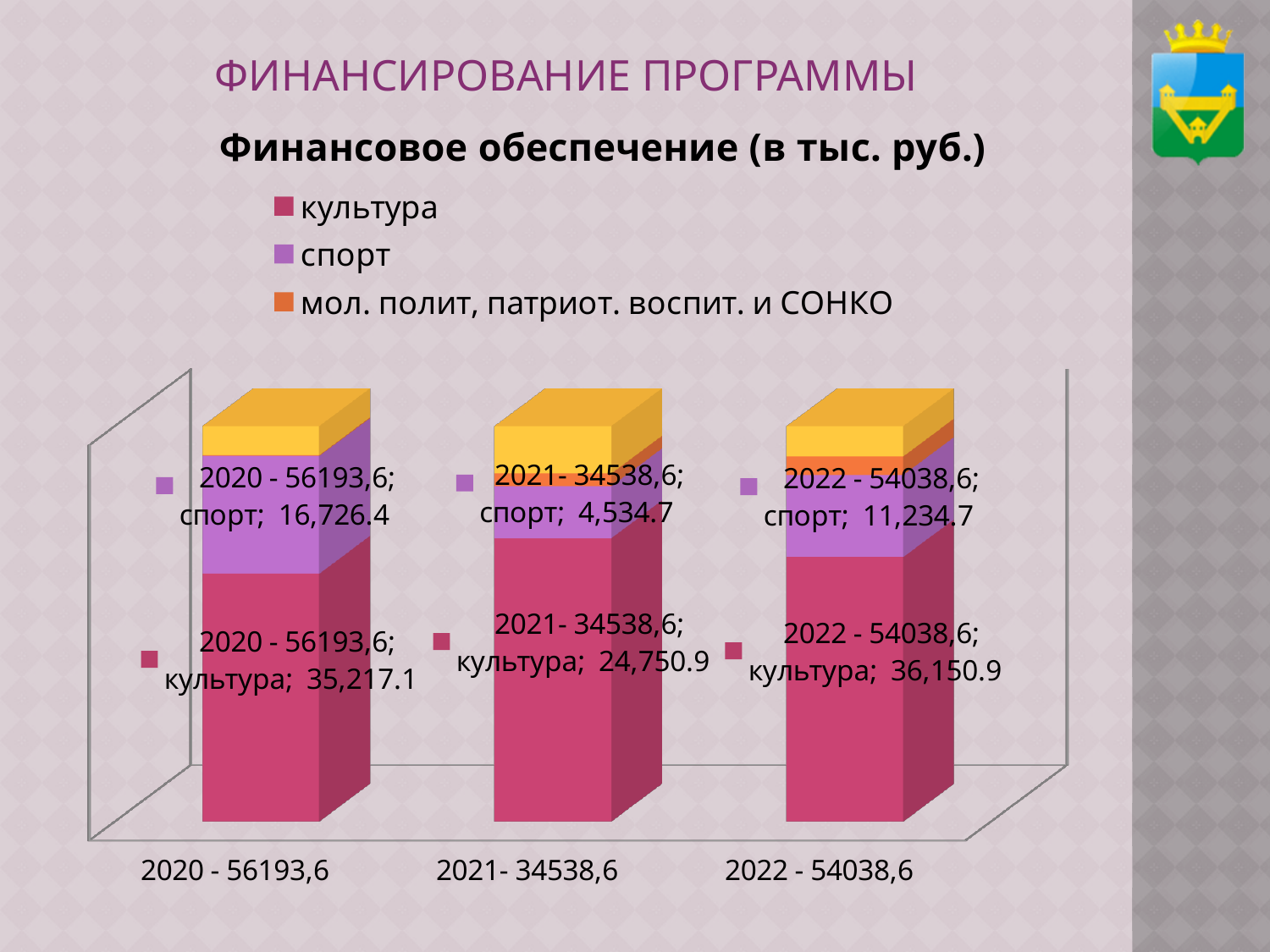
What is the value for культура in 2022? 36,150.9 How many years (categories) are shown on the chart? 3 In which year is the value for спорт the lowest? 2021 What is the difference between the культура values for 2022 and 2021? 11,400.0 How many series does the legend list? 3 What is the difference between the спорт values for 2020 and 2022? 5,491.7 What is the value for спорт in 2022? 11,234.7 What is the value for спорт in 2021? 4,534.7 In 2020, which is larger: the value for культура or the value for спорт? культура What kind of chart is shown on the slide? Stacked bar chart In which year is the value for культура the highest? 2022 What is the value for культура in 2020? 35,217.1